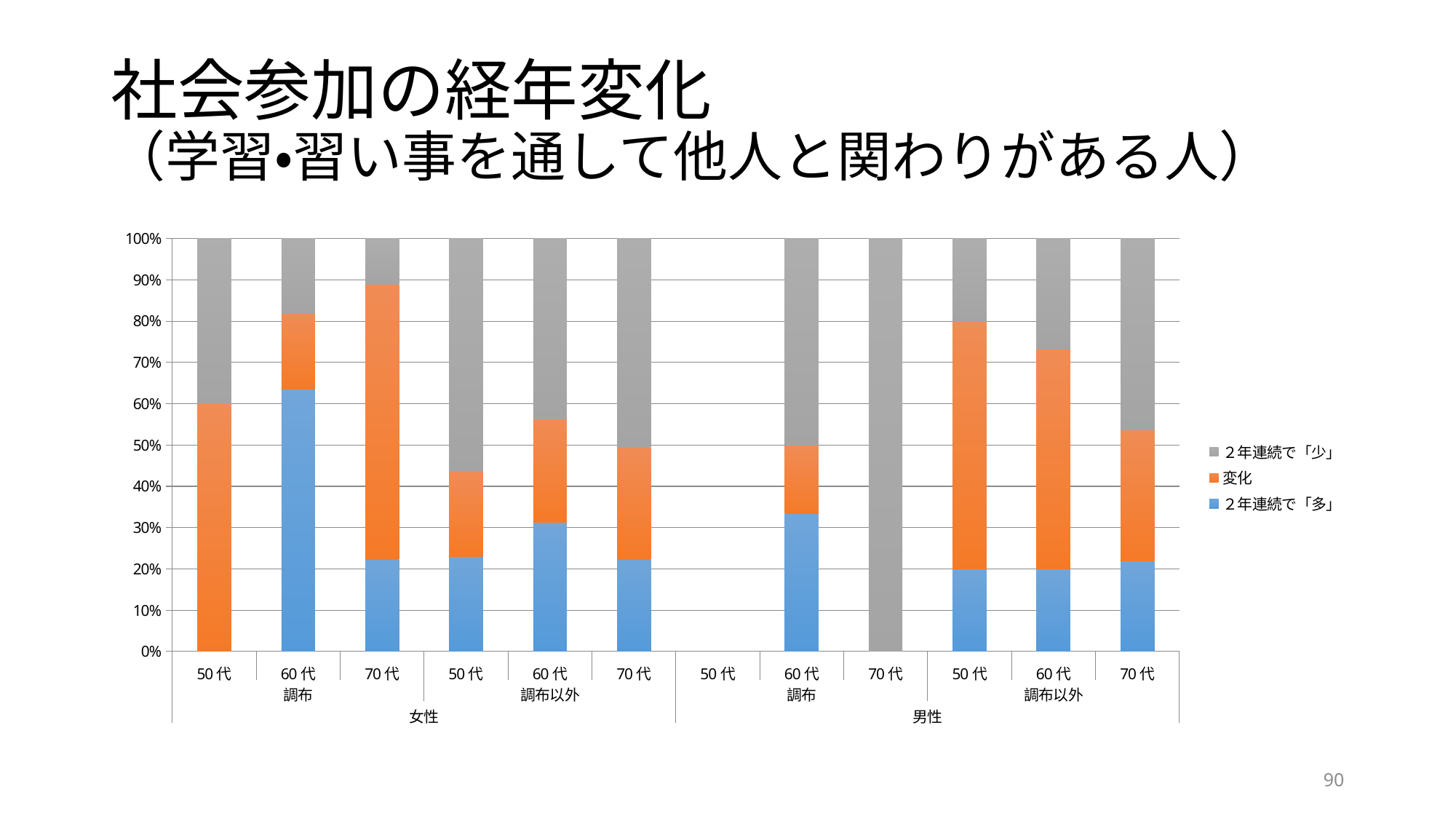
Is the ２年連続で「多」 (blue) share for 男性 調布以外 50代 greater or less than 30%? less Among the 女性 調布 bars, which age group has the largest ２年連続で「多」 (blue) share? 60代 Which category's bar consists entirely of the ２年連続で「少」 (gray) series? 男性 調布 70代 How many age-group categories are labelled along the x axis? 12 Which has the larger ２年連続で「多」 (blue) share: 女性 調布 60代 or 男性 調布 60代? 女性 調布 60代 Is the ２年連続で「多」 (blue) share for 女性 調布 60代 greater or less than 60%? greater Is the ２年連続で「少」 (gray) share for 女性 調布以外 50代 greater or less than 50%? greater Which legend entry is shown in gray? ２年連続で「少」 How many series does the legend list? 3 What kind of chart is shown on the slide? bar chart Which legend entry is shown in blue? ２年連続で「多」